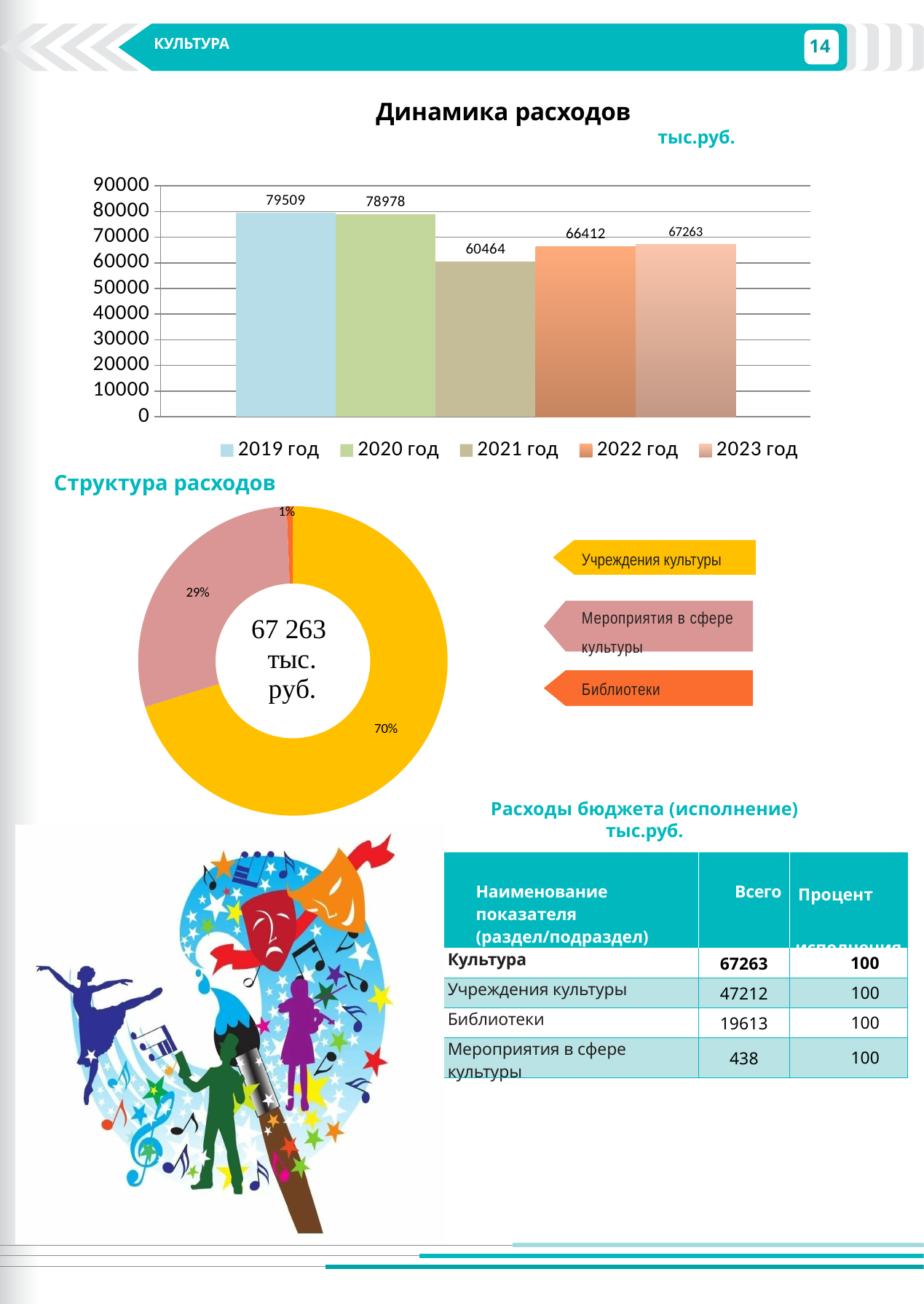
What total amount is shown in the centre of the 'Структура расходов' doughnut chart? 67 263 тыс. руб. In the 'Динамика расходов' bar chart, which is larger: the value for 2022 год or 2023 год? 2023 год In the 'Динамика расходов' bar chart, which year has the lowest value? 2021 год In the 'Динамика расходов' bar chart, what is the difference between the values for 2022 год and 2021 год? 5948 In the 'Динамика расходов' bar chart, what is the value for 2023 год? 67263 In the 'Структура расходов' doughnut chart, what share does Учреждения культуры have? 70% In the 'Динамика расходов' bar chart, how many years are shown? 5 In the 'Динамика расходов' bar chart, do the values rise or fall from 2019 год to 2021 год? fall What kind of chart is 'Динамика расходов'? bar chart In the 'Динамика расходов' bar chart, what is the value for 2019 год? 79509 In the 'Динамика расходов' bar chart, what is the value for 2021 год? 60464 In the 'Динамика расходов' bar chart, which year has the highest value? 2019 год